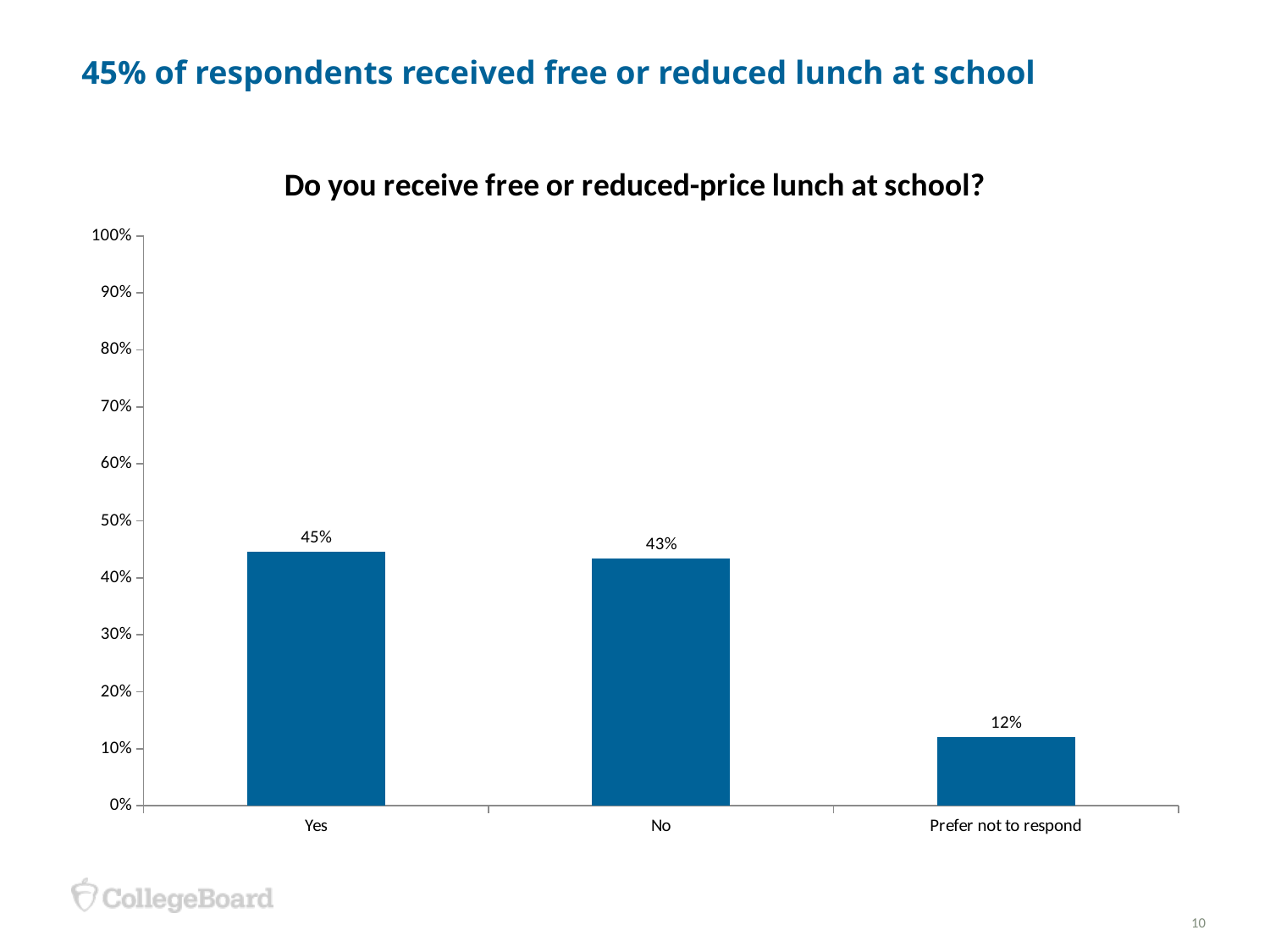
Is the value for "Prefer not to respond" greater or less than 10%? greater Which response category has the lowest percentage? Prefer not to respond Is the value for "Yes" greater or less than 50%? less What is the difference in percentage points between the "No" and "Prefer not to respond" responses? 31 percentage points What percentage of respondents chose "Prefer not to respond"? 12% What percentage of respondents answered "No"? 43% How many response categories are shown on the chart? 3 Which is larger, the percentage for "Yes" or for "Prefer not to respond"? Yes What is the difference in percentage points between the "Yes" and "No" responses? 2 percentage points What percentage of respondents answered "Yes" to receiving free or reduced-price lunch at school? 45% What is the title of the chart? Do you receive free or reduced-price lunch at school? What type of chart is shown on the slide? Bar chart